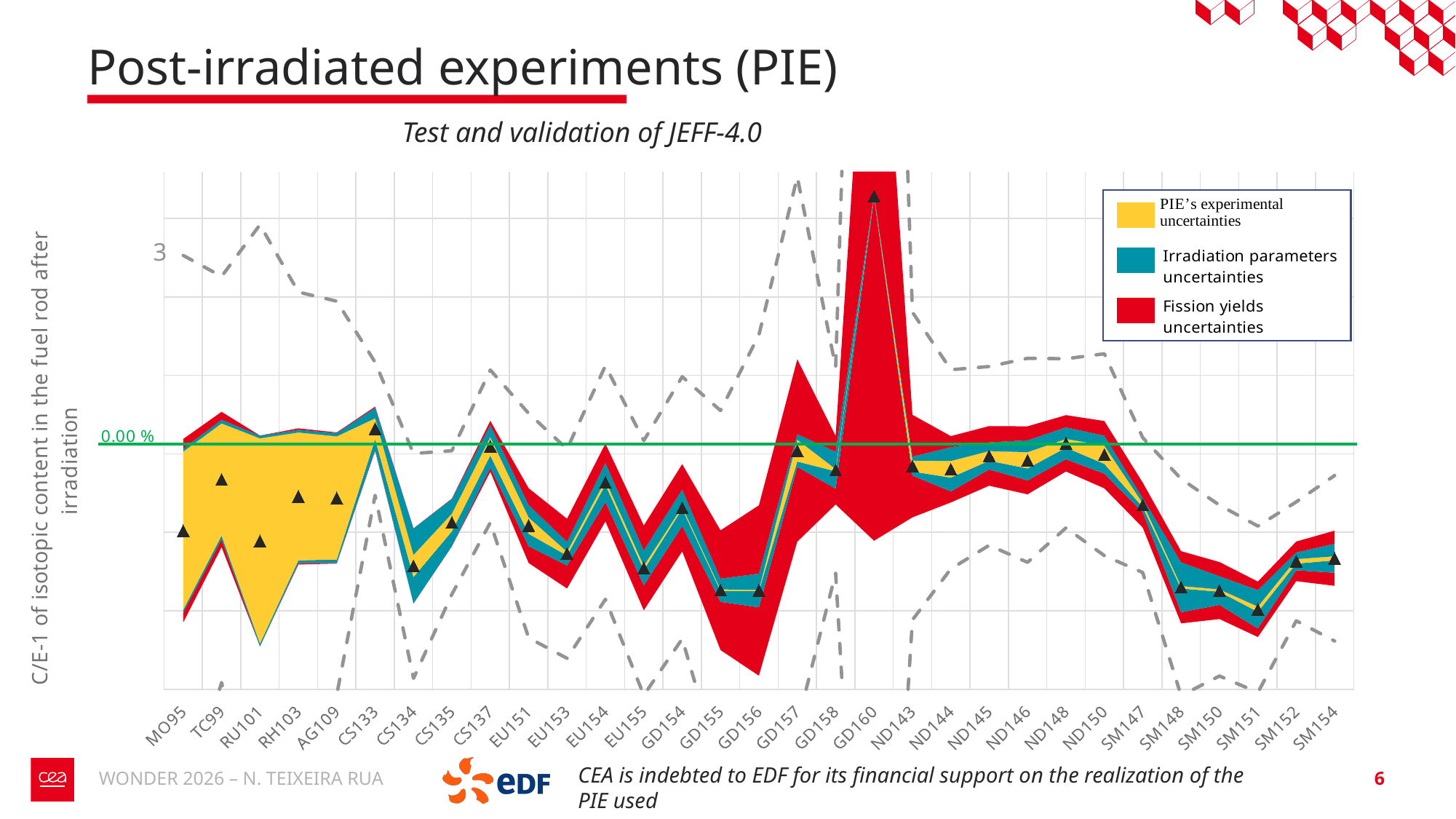
What kind of chart is shown on the slide? combination area and line chart Is the plotted value for CS134 greater or less than 0.00 %? less How many entries does the chart's legend list? 3 Is the plotted value for MO95 greater or less than 0.00 %? less Which has the larger plotted value, GD160 or GD156? GD160 What value is labelled on the green horizontal reference line? 0.00 % Which colour does the legend assign to fission yields uncertainties? red How many isotopes are listed along the x axis of the chart? 31 Which has the larger plotted value, CS133 or CS134? CS133 Which isotope has the highest plotted C/E-1 value? GD160 Is the plotted value for GD160 greater or less than 3? greater